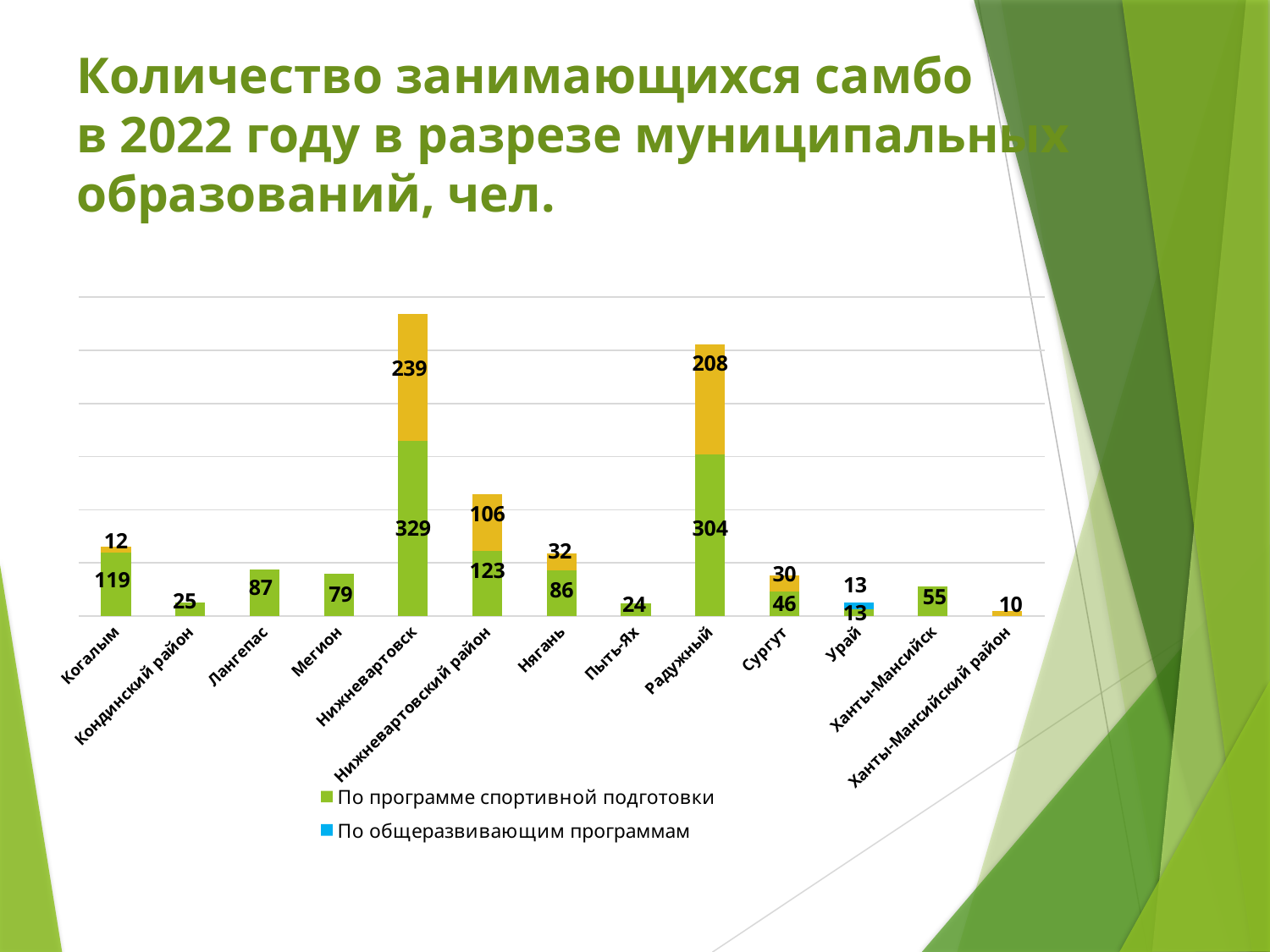
What is the value for Радужный in the series 'По программе спортивной подготовки'? 304 Which municipality has the highest value in the series 'По программе спортивной подготовки'? Нижневартовск What colour represents the series 'По программе спортивной подготовки' in the legend? green Which has the larger value in the series 'По программе спортивной подготовки', Лангепас or Мегион? Лангепас What is the value for Ханты-Мансийск in the series 'По программе спортивной подготовки'? 55 What is the value for Кондинский район in the series 'По программе спортивной подготовки'? 25 How many series does the chart legend list? 2 What is the difference between Нижневартовск and Радужный in the series 'По программе спортивной подготовки'? 25 What is the total of the stacked bar for Нижневартовск? 568 How many municipalities are shown along the x axis of the chart? 13 What is the value for Нижневартовск in the series 'По программе спортивной подготовки'? 329 What kind of chart is shown on the slide? bar chart